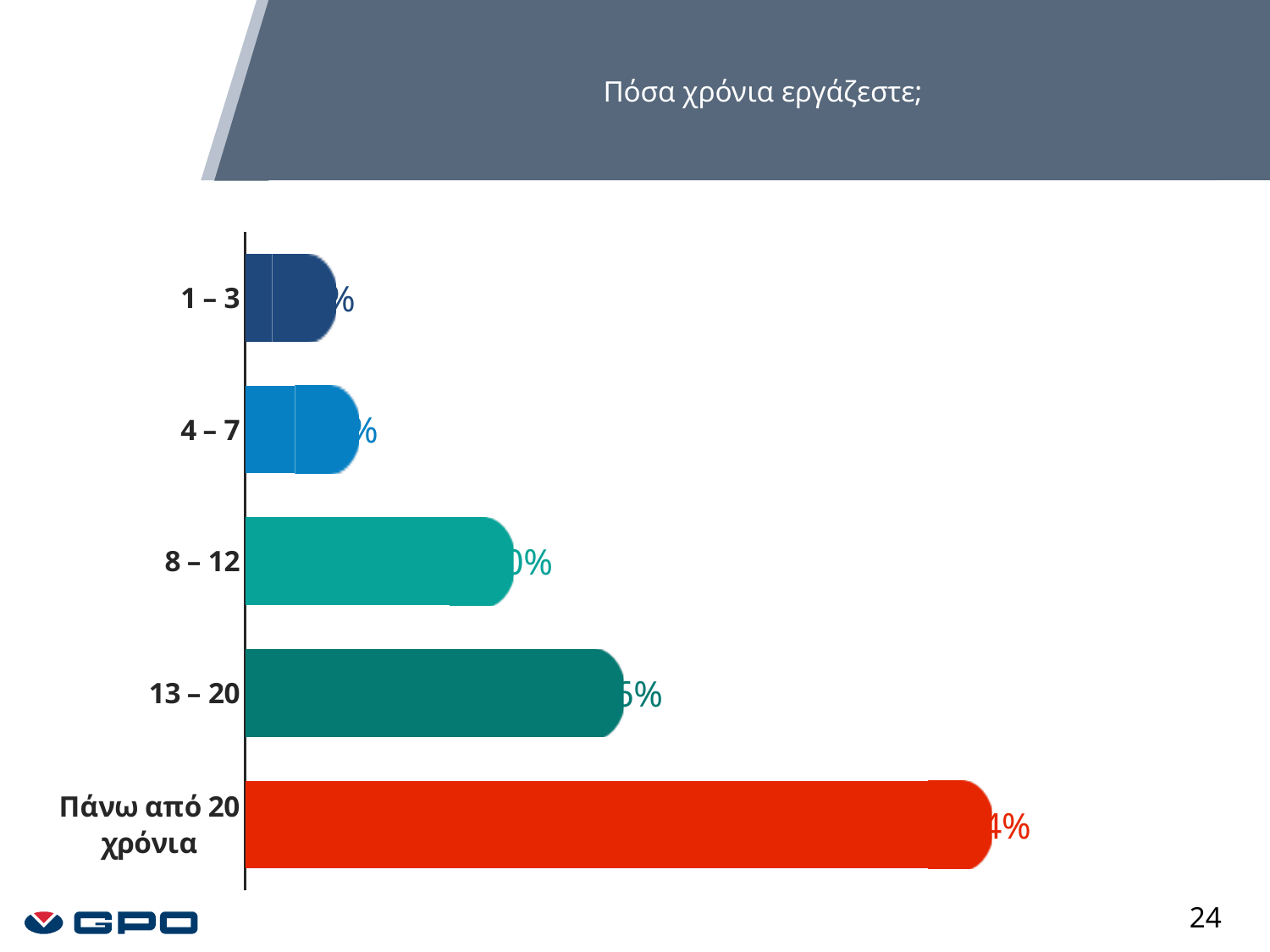
What is the title of the chart? Πόσα χρόνια εργάζεστε; Which is larger, the value for 13 – 20 or the value for Πάνω από 20 χρόνια? Πάνω από 20 χρόνια Which is larger, the value for 1 – 3 or the value for 13 – 20? 13 – 20 Which is larger, the value for 4 – 7 or the value for 8 – 12? 8 – 12 Do the bars get longer or shorter going from the top category (1 – 3) to the bottom category (Πάνω από 20 χρόνια)? longer How many categories are shown in the chart? 5 What colour is the bar for Πάνω από 20 χρόνια? red Which category has the highest value? Πάνω από 20 χρόνια What type of chart is shown on the slide? bar chart